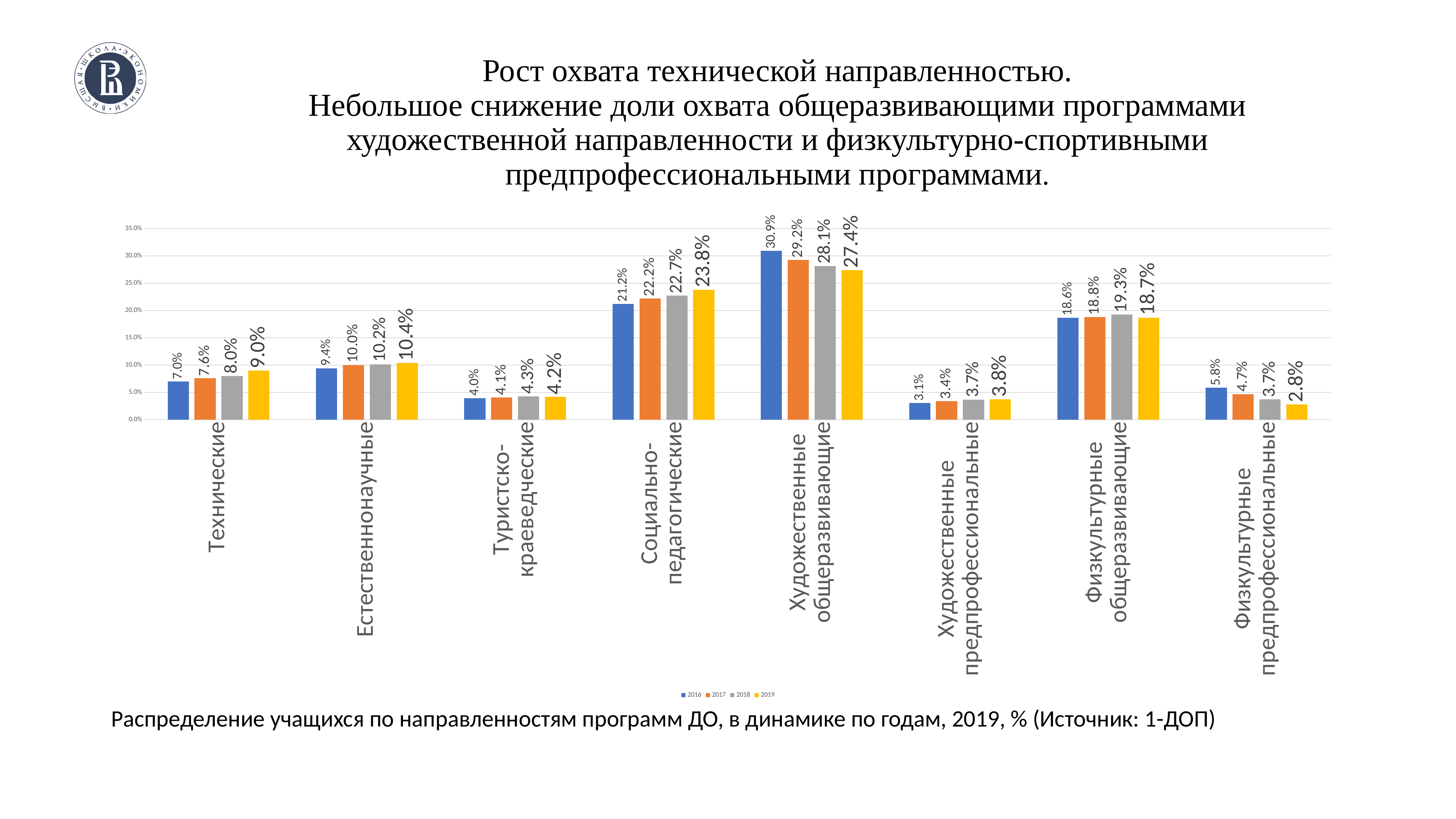
Do the values for Физкультурные предпрофессиональные rise or fall from 2016 to 2019? fall What is the value for Художественные общеразвивающие in 2016? 30.9% What is the value for Технические in 2019? 9.0% How many categories are shown on the x axis? 8 What is the difference between the 2016 and 2019 values for Художественные общеразвивающие? 3.5% Which category has the lowest value in 2019? Физкультурные предпрофессиональные What is the difference between the 2019 and 2016 values for Социально-педагогические? 2.6% Which is larger: the 2019 value for Естественнонаучные or the 2019 value for Технические? Естественнонаучные Is the 2019 value for Социально-педагогические greater or less than 20.0%? greater What is the value for Физкультурные предпрофессиональные in 2018? 3.7% Which category has the highest value in 2019? Художественные общеразвивающие How many series does the legend list? 4